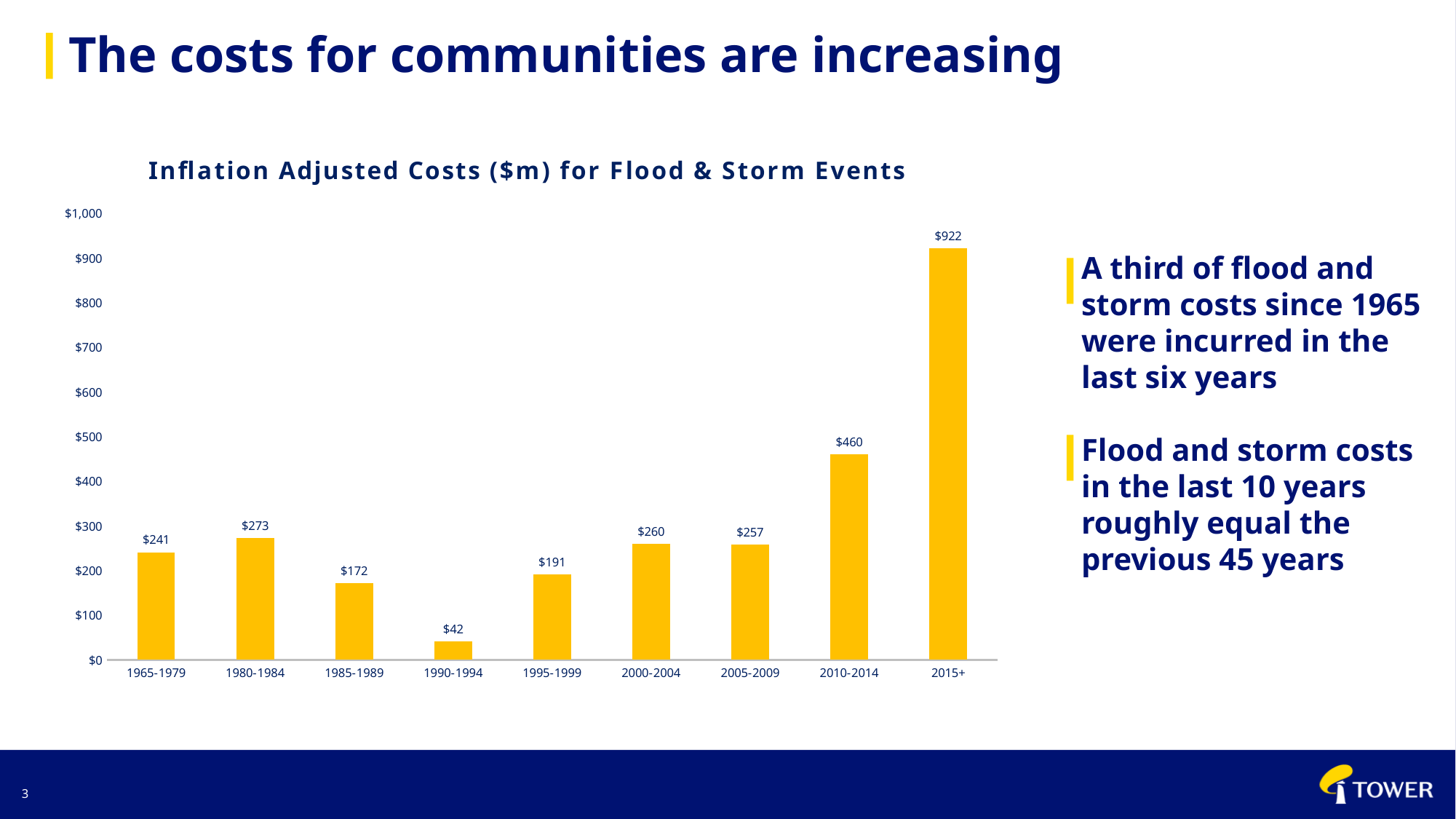
What is the inflation adjusted cost for flood and storm events in 2010-2014? $460 What is the inflation adjusted cost for flood and storm events in 2015+? $922 What is the inflation adjusted cost for flood and storm events in 1990-1994? $42 Is the inflation adjusted cost for 2010-2014 greater or less than $400? greater What is the difference between the inflation adjusted costs for 2015+ and 2010-2014? $462 What is the title of the chart on the slide? Inflation Adjusted Costs ($m) for Flood & Storm Events How many time periods are shown on the x axis of the chart? 9 What kind of chart is used to show the inflation adjusted costs for flood and storm events? Bar chart Which period has the lowest inflation adjusted cost for flood and storm events? 1990-1994 Which period has a higher inflation adjusted cost: 1985-1989 or 1995-1999? 1995-1999 What is the difference between the inflation adjusted costs for 1980-1984 and 1965-1979? $32 Which period has the highest inflation adjusted cost for flood and storm events? 2015+